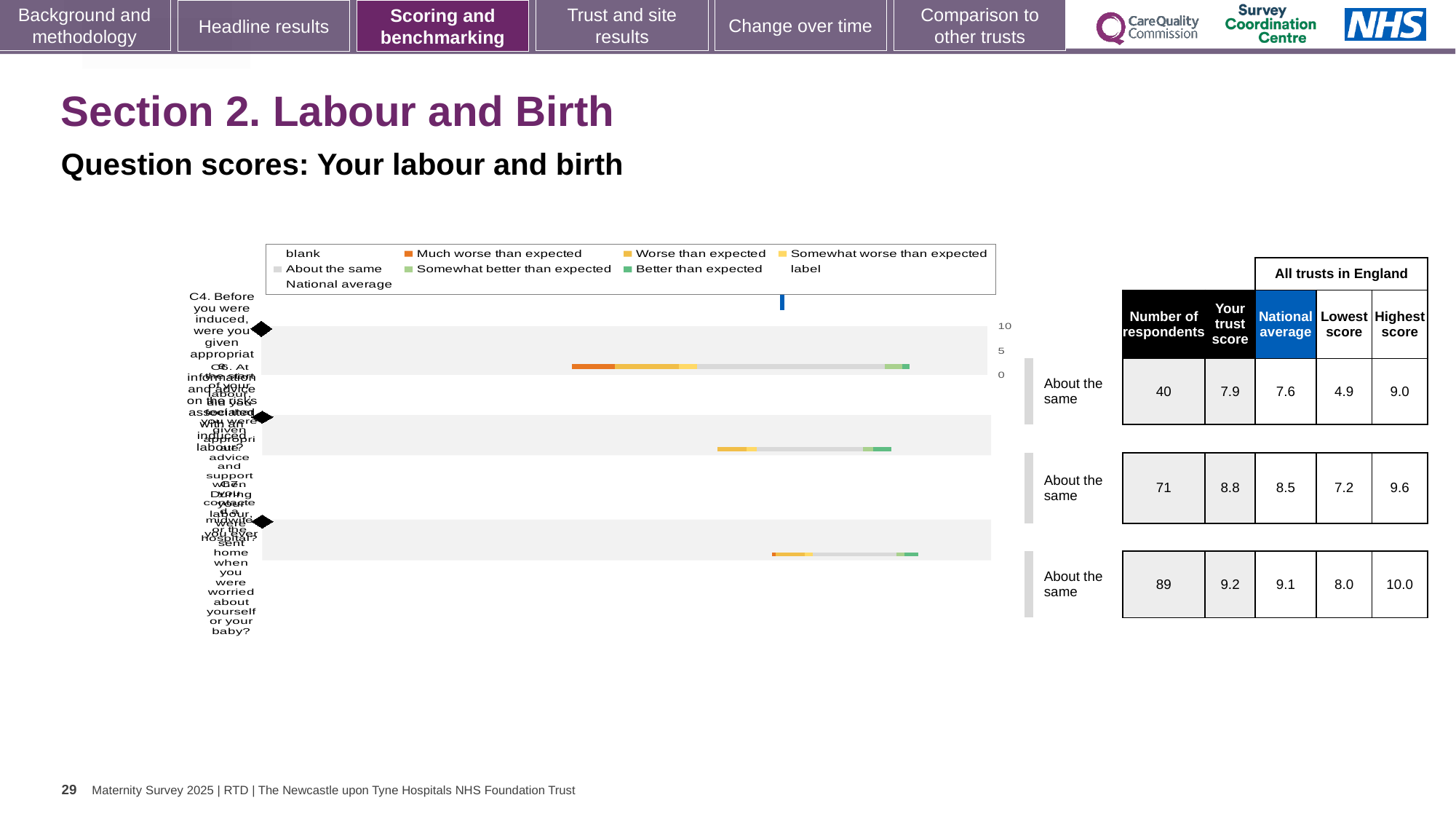
Which question row has the largest number of respondents? the third (bottom) row What kind of chart is shown on the slide? bar chart Which three columns are grouped under the heading 'All trusts in England'? National average, Lowest score, Highest score What is the difference between the trust score and the national average for the second question row? 0.3 What is the highest score for the third (bottom) question row? 10.0 How many question rows are plotted in the chart? 3 What is the lowest score for the second question row? 7.2 What is the trust score for the first (top) question row? 7.9 For the third (bottom) question row, which is larger: the trust score or the national average? the trust score What benchmark category is shown next to each of the three question rows? About the same What is the number of respondents for the first (top) question row? 40 What is the national average for the second question row? 8.5